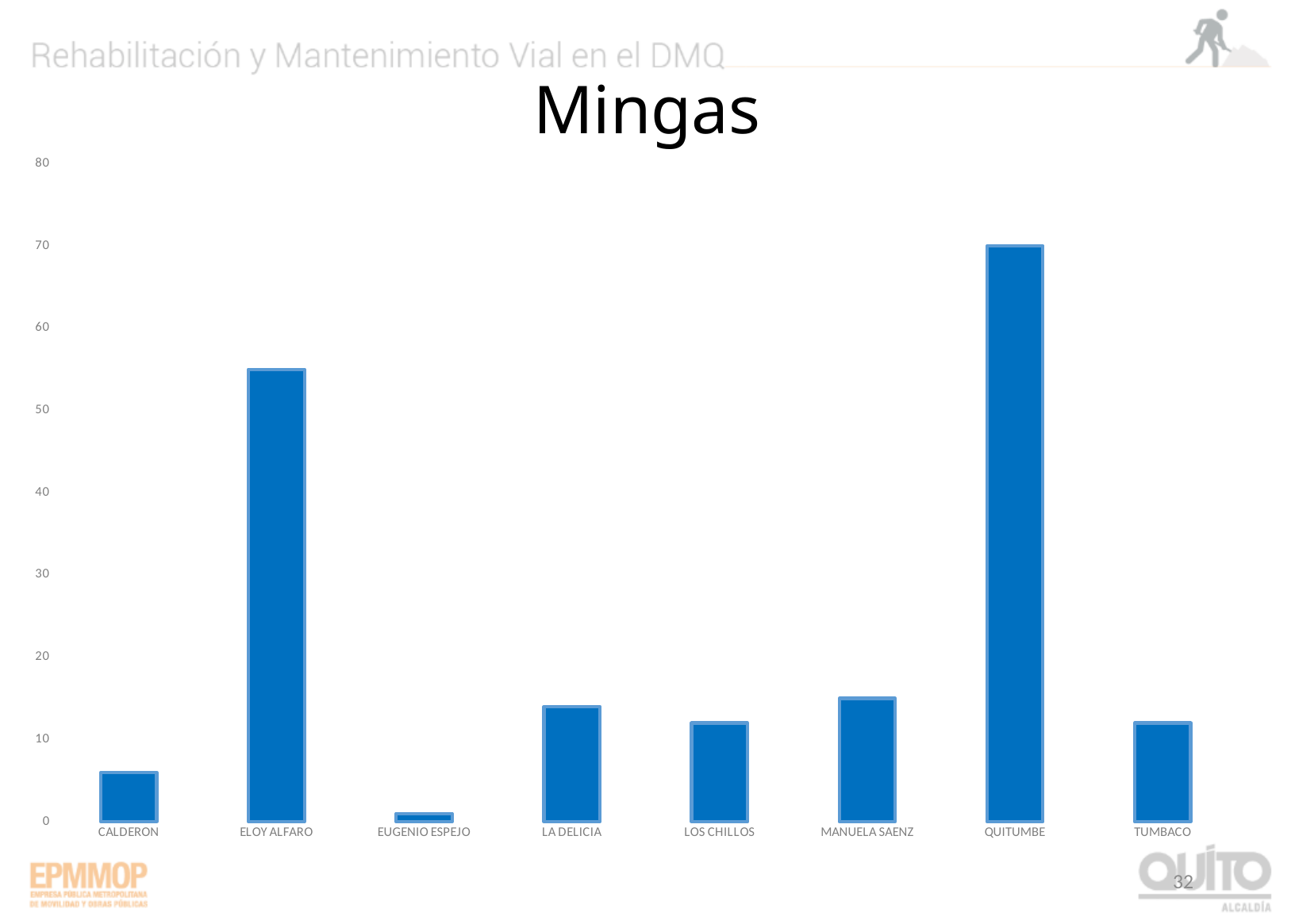
How many categories are shown on the x axis? 8 Which category has the highest value? QUITUMBE What type of chart is shown on the slide? bar chart Is the value for MANUELA SAENZ greater or less than 10? greater Which is larger, the value for ELOY ALFARO or the value for MANUELA SAENZ? ELOY ALFARO Is the value for ELOY ALFARO greater or less than 50? greater Is the value for LA DELICIA greater or less than 20? less Which is larger, the value for CALDERON or the value for TUMBACO? TUMBACO Which category has the lowest value? EUGENIO ESPEJO What is the title of the chart? Mingas